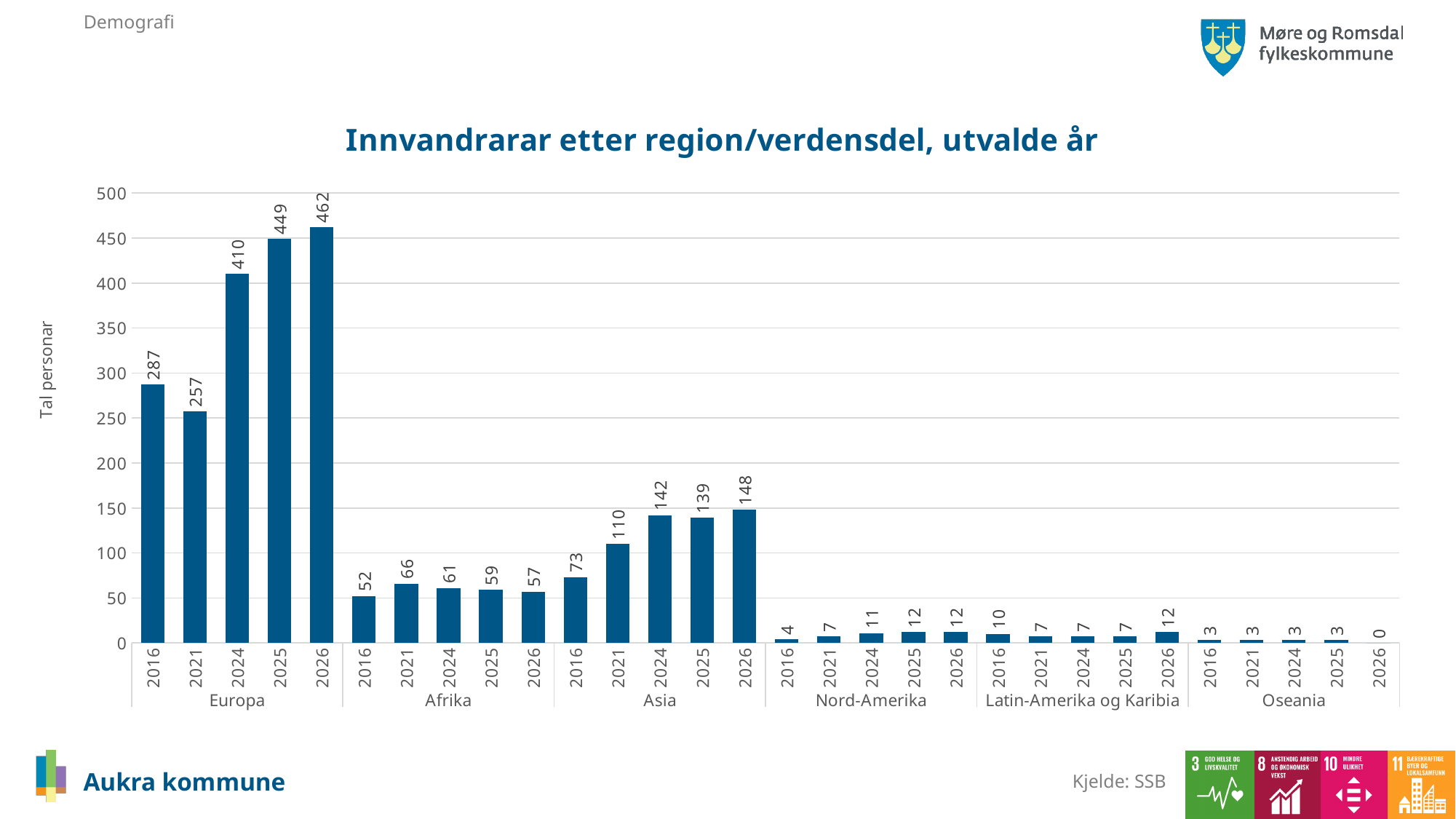
What kind of chart is shown on the slide? Bar chart Which is larger: Asia in 2025 or Asia in 2024? Asia in 2024 What is the value for Asia in 2021? 110 What is the value for Oseania in 2026? 0 What is the value for Afrika in 2016? 52 What is the title of the chart? Innvandrarar etter region/verdensdel, utvalde år What is the value for Europa in 2026? 462 What is the difference between the Europa values for 2026 and 2016? 175 Do the values for Nord-Amerika rise or fall from 2016 to 2025? Rise How many regions are shown on the x axis? 6 Which year has the lowest value within the Europa group? 2021 Which region has the highest bar on the chart? Europa